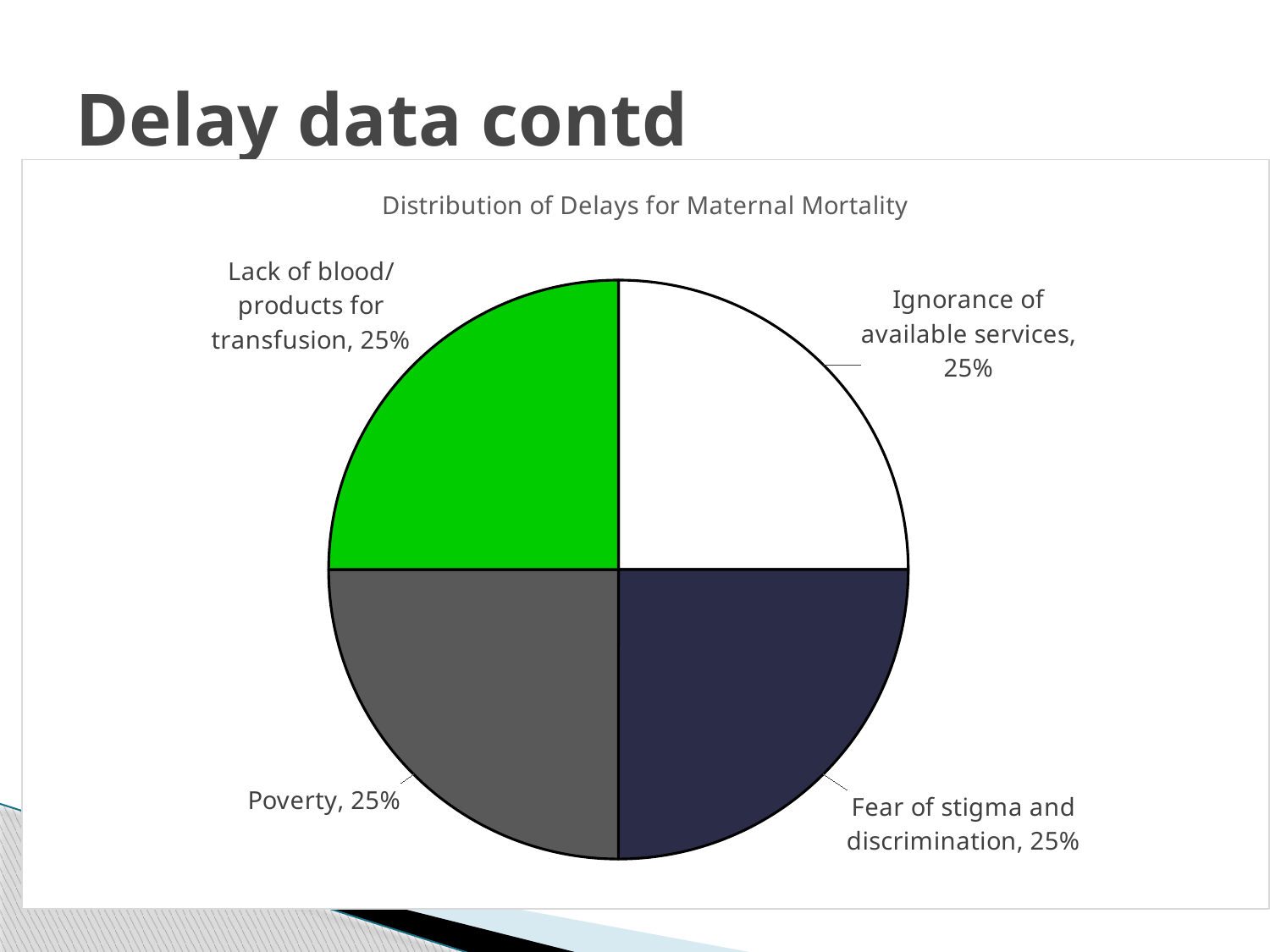
What kind of chart is shown on the slide? pie chart Which colour is the Poverty slice? grey What share of the pie is Poverty? 25% What is the difference between the values for Poverty and Fear of stigma and discrimination? 0% Is the value for Poverty greater or less than 50%? less What is the value shown for Lack of blood/ products for transfusion? 25% How many slices does the pie chart have? 4 What is the value shown for Fear of stigma and discrimination? 25% What is the value shown for Ignorance of available services? 25% What is the title of the chart? Distribution of Delays for Maternal Mortality